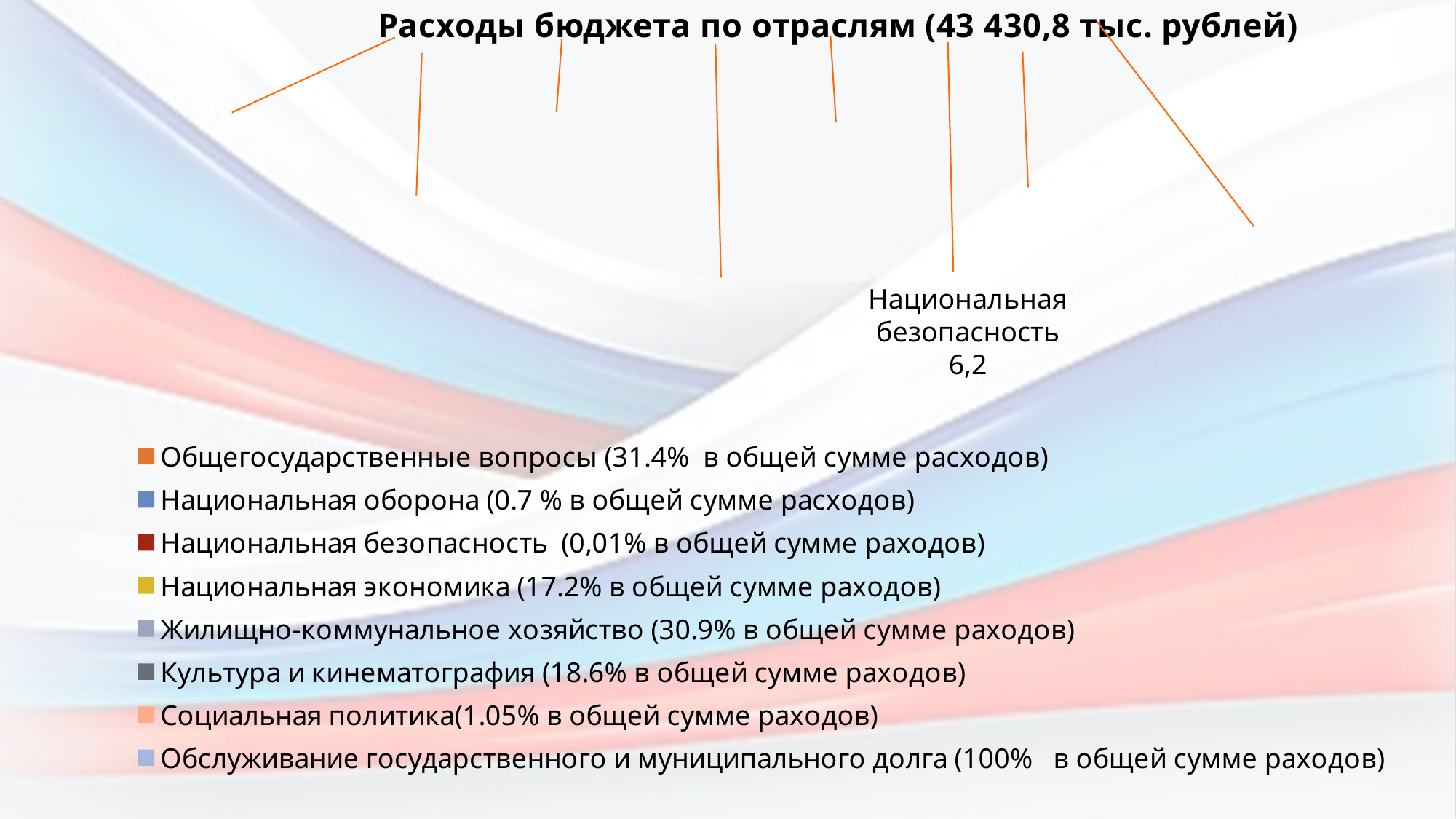
What share of total expenditure does the legend give for Культура и кинематография? 18.6% What share of total expenditure does the legend give for Национальная экономика? 17.2% What share of total expenditure does the legend give for Национальная оборона? 0.7 % What total budget amount is given in the chart title? 43 430,8 тыс. рублей What share of total expenditure does the legend give for Социальная политика? 1.05% What share of total expenditure does the legend give for Жилищно-коммунальное хозяйство? 30.9% How many entries does the chart legend list? 8 According to the legend, by how many percentage points does the share of Общегосударственные вопросы exceed that of Жилищно-коммунальное хозяйство? 0.5 According to the legend, which has the larger share: Общегосударственные вопросы or Жилищно-коммунальное хозяйство? Общегосударственные вопросы What share of total expenditure does the legend give for Общегосударственные вопросы? 31.4% What is the title of the chart on the slide? Расходы бюджета по отраслям (43 430,8 тыс. рублей) What value is shown in the data label for Национальная безопасность? 6,2